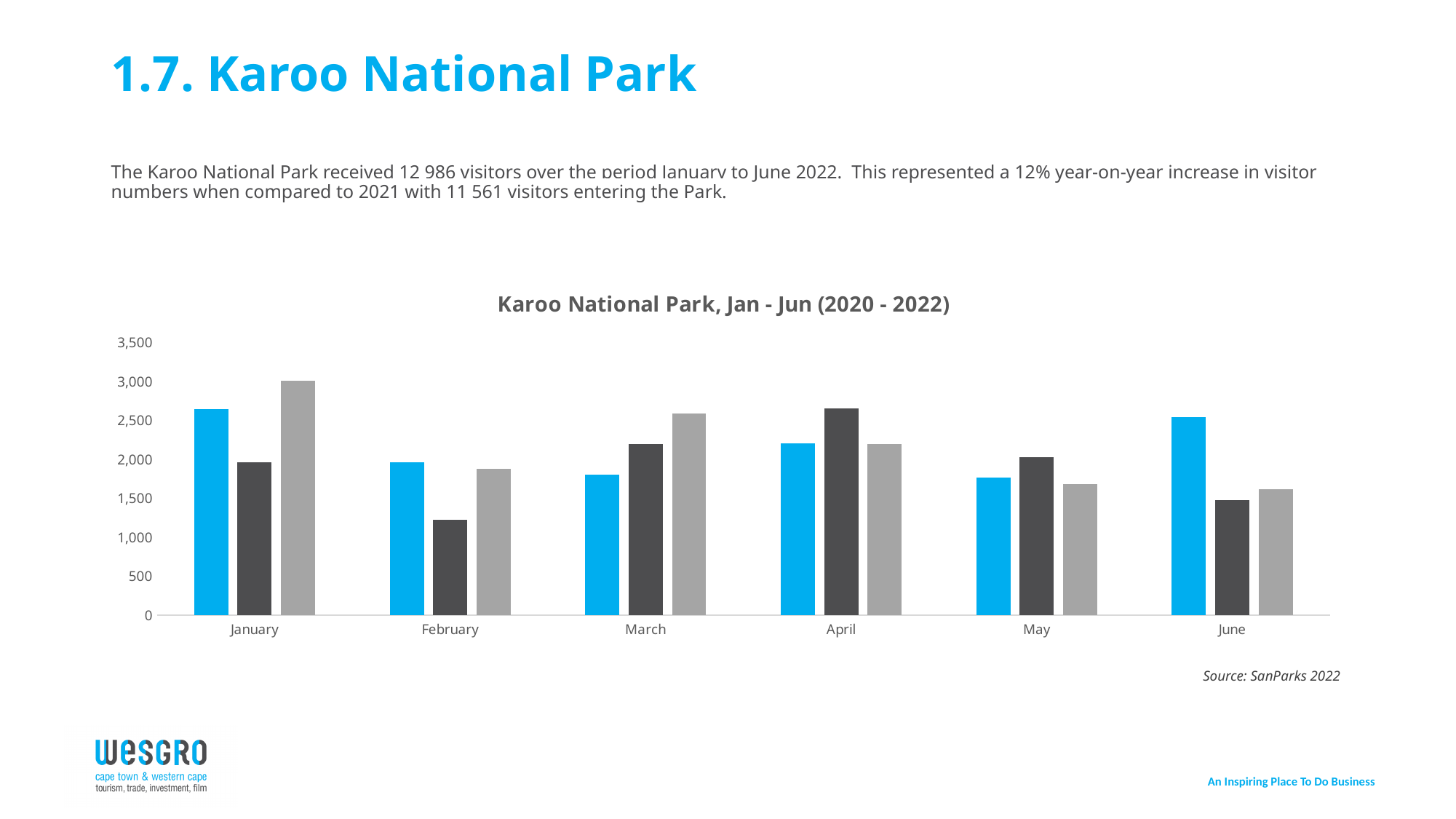
How many bars are plotted for each month in the chart? 3 In June, which is taller: the blue bar or the dark grey bar? the blue bar Is the dark grey bar for February greater or less than 1,500? less What is the title of the chart? Karoo National Park, Jan - Jun (2020 - 2022) What kind of chart is shown on the slide? bar chart In March, which is taller: the blue bar or the light grey bar? the light grey bar Is the light grey bar for May greater or less than 2,000? less Which month has the shortest bar in the chart? February Which month has the tallest bar in the chart? January Is the light grey bar for January greater or less than 2,500? greater How many months are shown on the x axis of the chart? 6